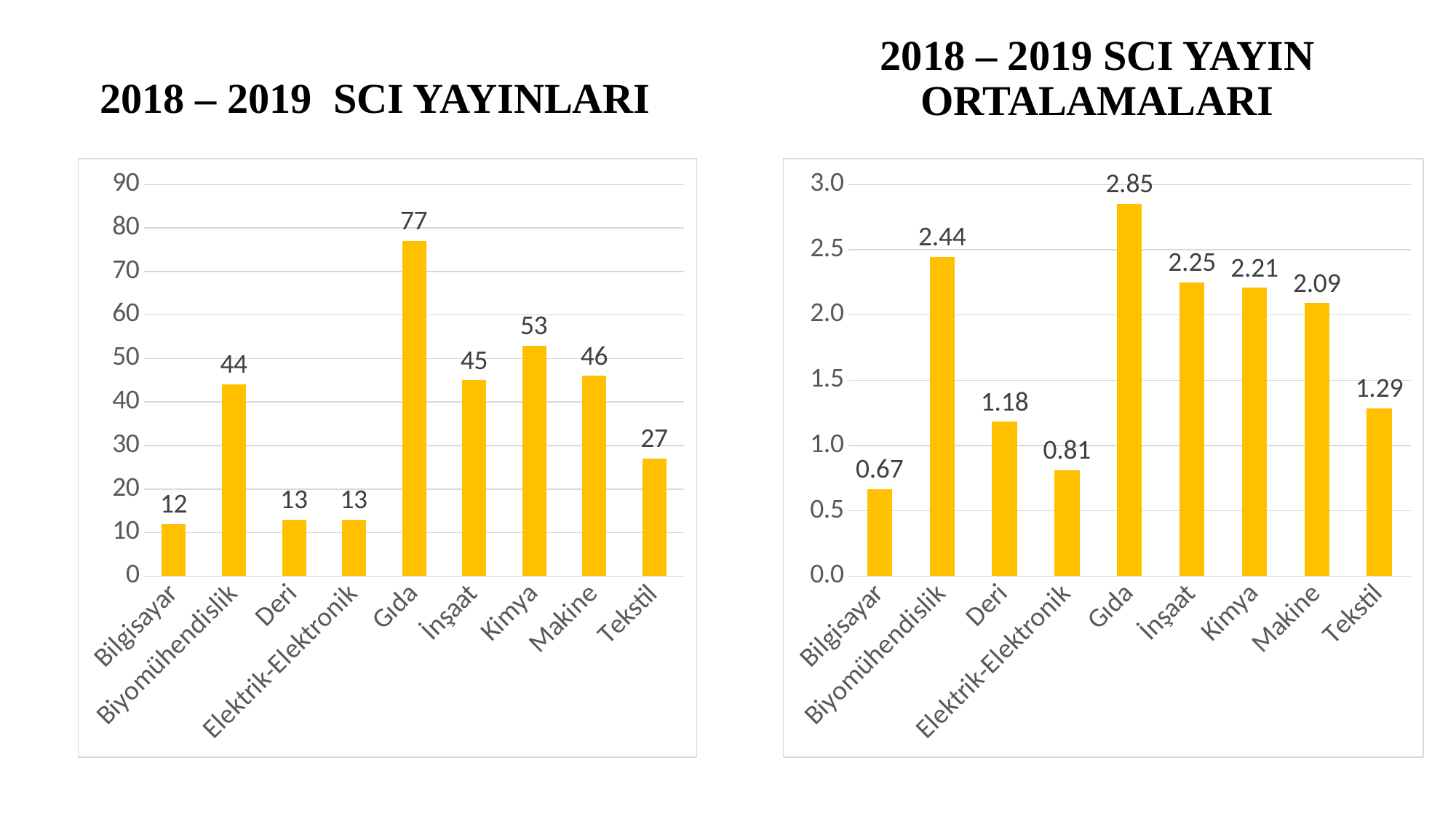
In the right chart (2018 – 2019 SCI YAYIN ORTALAMALARI), what is the difference between Gıda and Bilgisayar? 2.18 In the right chart (2018 – 2019 SCI YAYIN ORTALAMALARI), what is the value for Tekstil? 1.29 In the right chart (2018 – 2019 SCI YAYIN ORTALAMALARI), what is the value for Biyomühendislik? 2.44 In the left chart (2018 – 2019 SCI YAYINLARI), what is the difference between Kimya and Makine? 7 In the right chart (2018 – 2019 SCI YAYIN ORTALAMALARI), which category has the highest value? Gıda What kind of chart is the left chart (2018 – 2019 SCI YAYINLARI)? Bar chart In the left chart (2018 – 2019 SCI YAYINLARI), what is the value for Gıda? 77 In the left chart (2018 – 2019 SCI YAYINLARI), how many categories are shown on the x axis? 9 In the right chart (2018 – 2019 SCI YAYIN ORTALAMALARI), which is larger, Deri or Elektrik-Elektronik? Deri In the left chart (2018 – 2019 SCI YAYINLARI), which category has the lowest value? Bilgisayar In the left chart (2018 – 2019 SCI YAYINLARI), what is the value for Tekstil? 27 What is the title of the right chart? 2018 – 2019 SCI YAYIN ORTALAMALARI